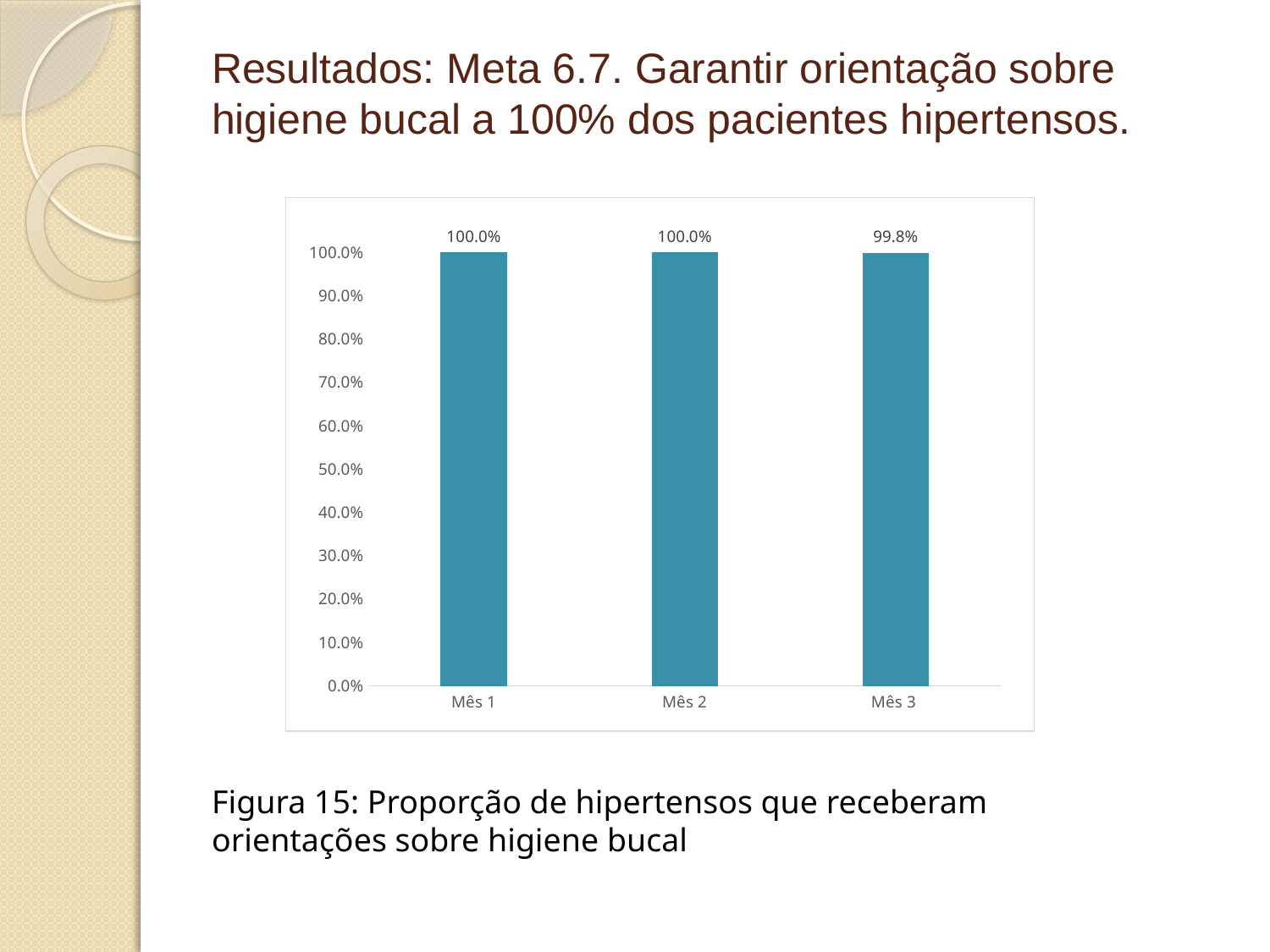
What is the figure caption below the chart? Figura 15: Proporção de hipertensos que receberam orientações sobre higiene bucal What is the value for Mês 2? 100.0% What is the highest tick value shown on the y axis? 100.0% What kind of chart is shown on the slide? bar chart What is the value for Mês 1? 100.0% Which is larger, the value for Mês 2 or the value for Mês 3? Mês 2 Which month has the lowest value? Mês 3 Do the values rise, fall or stay the same from Mês 1 to Mês 2? stay the same How many months are shown on the x axis? 3 What is the value for Mês 3? 99.8% What is the difference between the values for Mês 1 and Mês 3? 0.2% Is the value for Mês 3 greater or less than 90.0%? greater